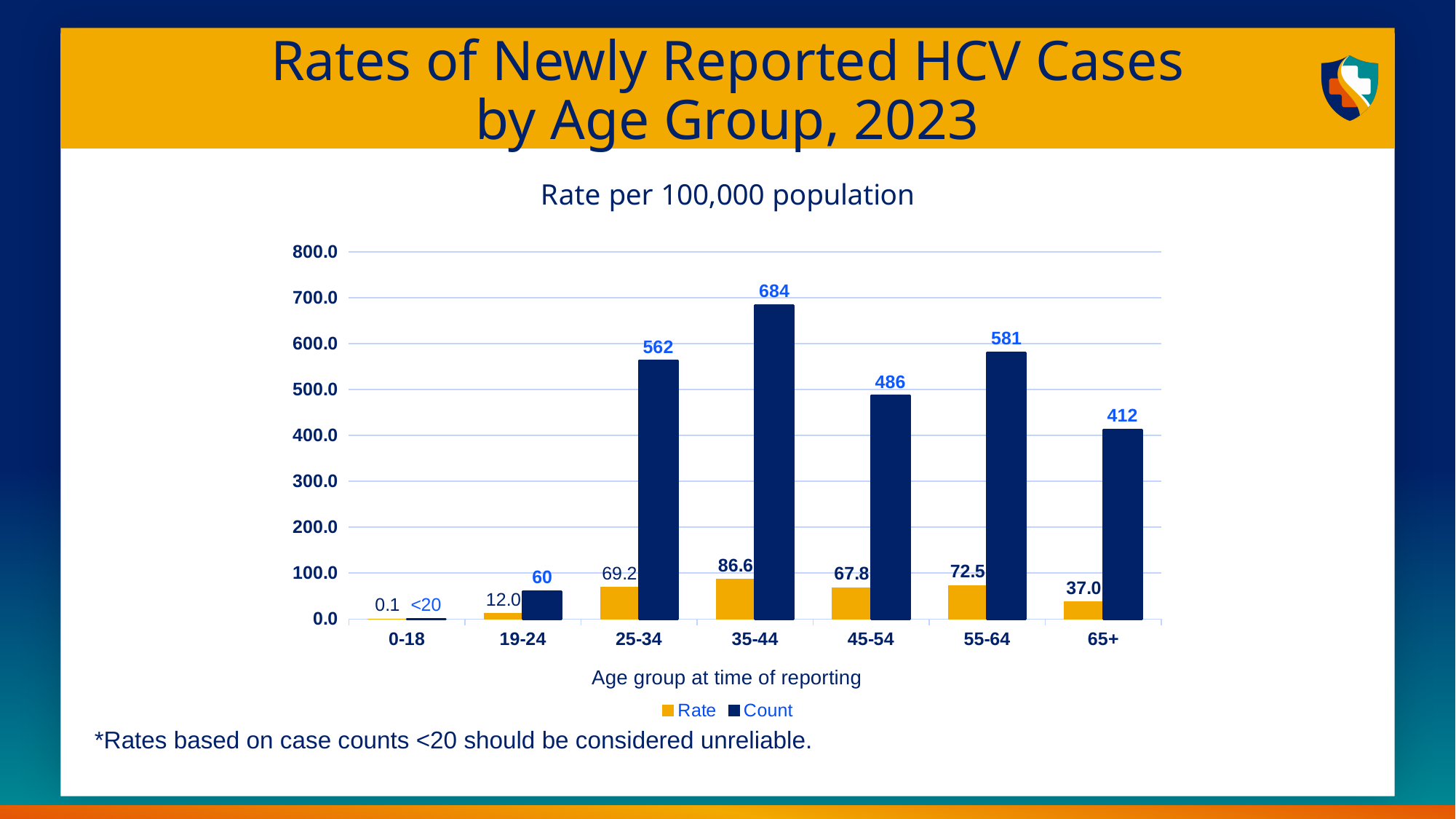
What is the Rate value for the 25-34 age group? 69.2 Is the Count value for 45-54 greater or less than 400? greater What is the Count value for the 35-44 age group? 684 What is the x-axis label of the chart? Age group at time of reporting How many age groups are shown on the x axis? 7 What is the Rate value for the 65+ age group? 37.0 Which is larger, the Count for 25-34 or the Count for 55-64? 55-64 What kind of chart is shown on the slide? bar chart What is the difference between the Count for 35-44 and the Count for 65+? 272 Which age group has the highest Count? 35-44 How many series does the legend list? 2 Which age group has the lowest Rate? 0-18